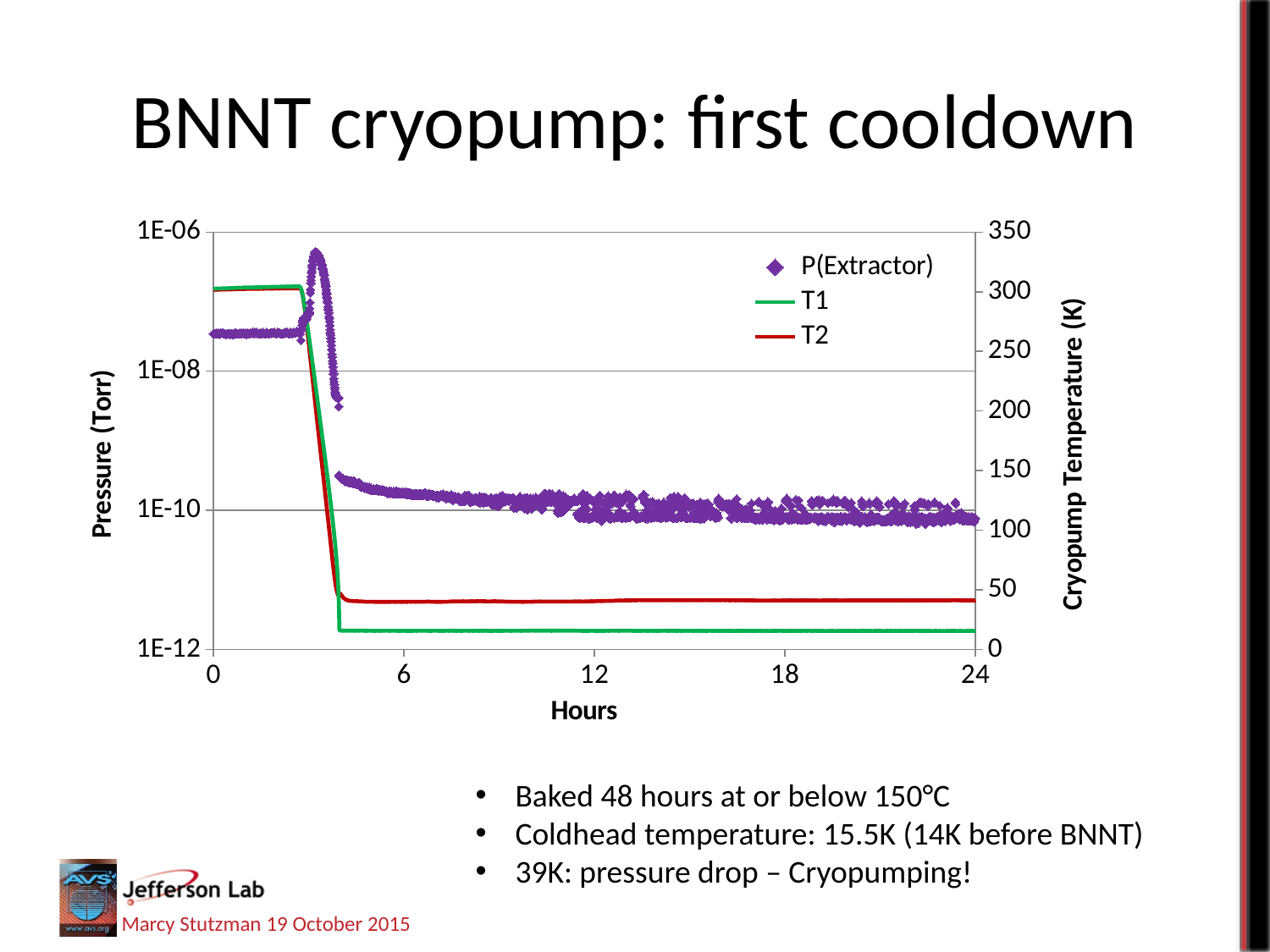
What is the title of the left vertical axis of the chart? Pressure (Torr) Is the peak P(Extractor) pressure greater or less than 1E-08 Torr? greater Does the T1 temperature rise or fall over the 24 hours shown? fall Is the T1 temperature at 24 hours greater or less than 50 K? less What kind of chart is shown on the slide? line chart Is the P(Extractor) pressure at 24 hours greater or less than 1E-08 Torr? less What is the title of the right vertical axis of the chart? Cryopump Temperature (K) At 24 hours, which series shows the higher temperature, T1 or T2? T2 Does the P(Extractor) pressure rise or fall between 6 hours and 24 hours? fall How many series does the chart legend list? 3